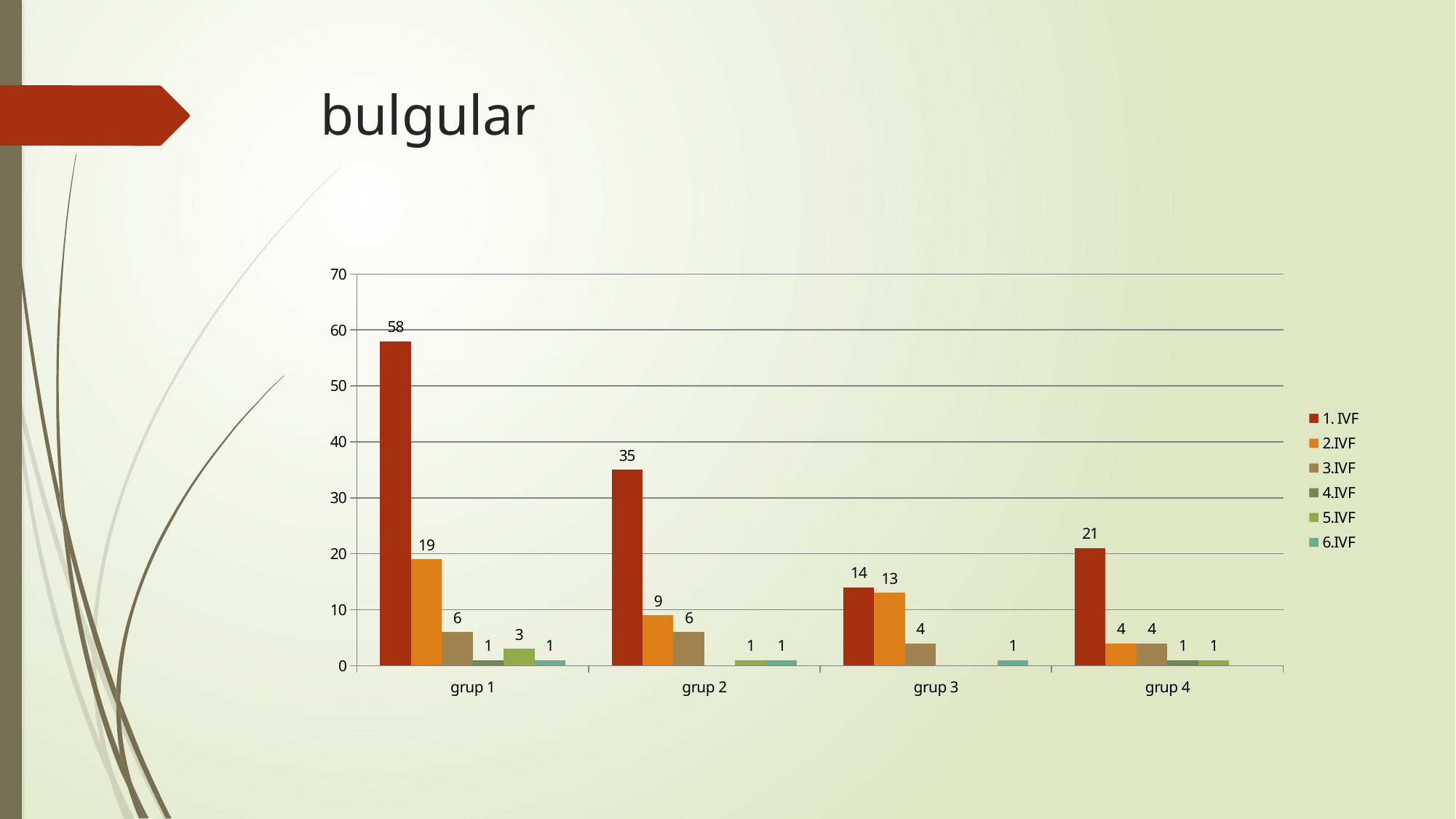
What type of chart is shown on the slide? bar chart Which group has the lowest 1. IVF value? grup 3 How many series does the legend list? 6 What is the value of 2.IVF for grup 3? 13 What is the title of the chart? bulgular What is the value of 5.IVF for grup 1? 3 Which is larger: the 2.IVF value for grup 1 or the 2.IVF value for grup 2? grup 1 What is the value of 1. IVF for grup 4? 21 How many groups are shown on the x axis? 4 What is the difference between the 1. IVF values for grup 1 and grup 2? 23 What is the value of 1. IVF for grup 1? 58 Which group has the highest 1. IVF value? grup 1